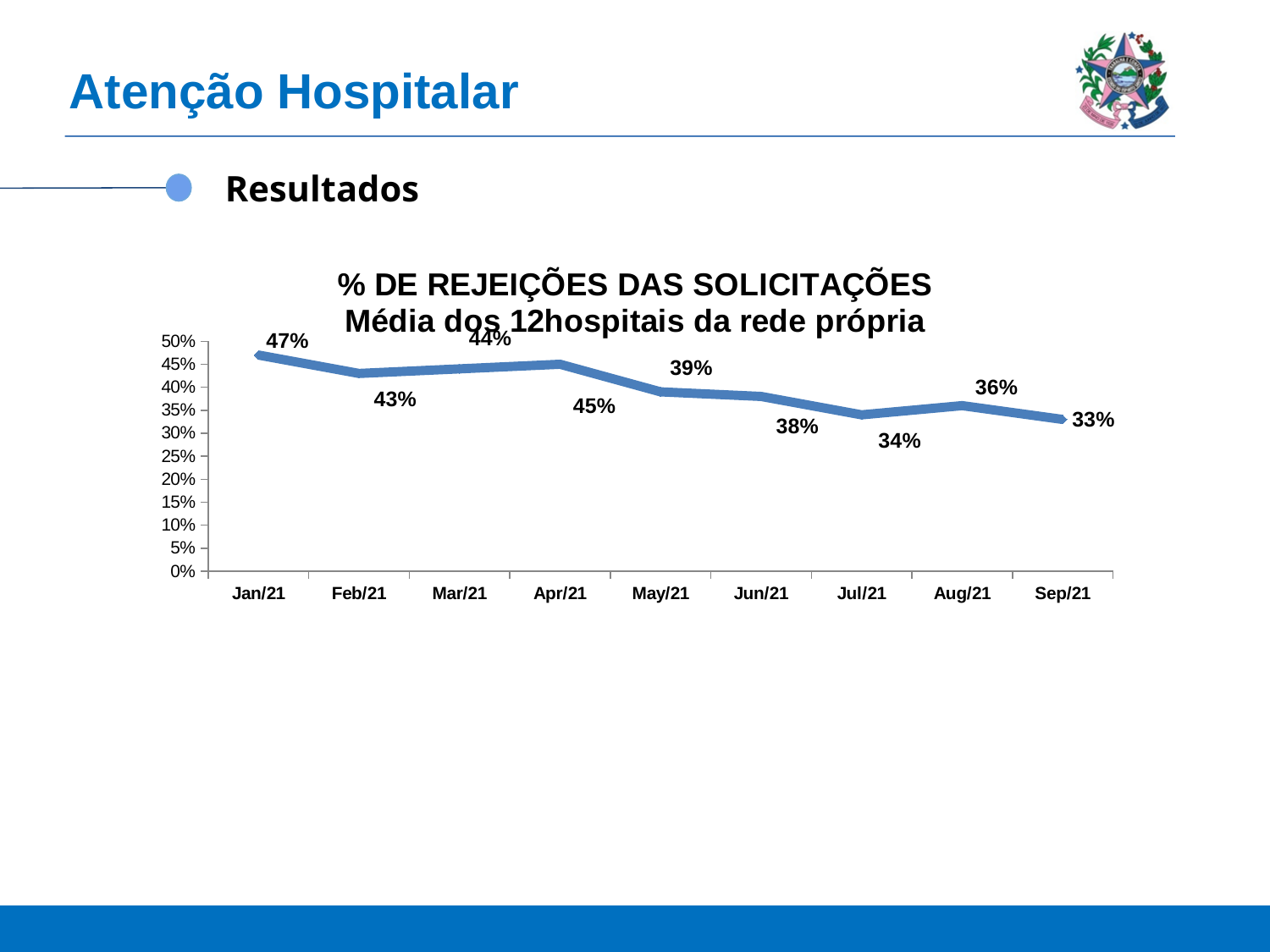
Do the values generally rise or fall from Jan/21 to Sep/21? Fall What is the difference between the values for Apr/21 and May/21? 6% What kind of chart is shown on the slide? Line chart Which month has the lowest rejection percentage? Sep/21 What is the value for Sep/21? 33% What is the value for Jul/21? 34% Which is larger, the value for Aug/21 or the value for Jul/21? Aug/21 How many months are plotted on the x axis? 9 What is the title of the chart? % DE REJEIÇÕES DAS SOLICITAÇÕES Média dos 12hospitais da rede própria What is the difference between the values for Jan/21 and Sep/21? 14% What is the value for Jan/21? 47% Which month has the highest rejection percentage? Jan/21